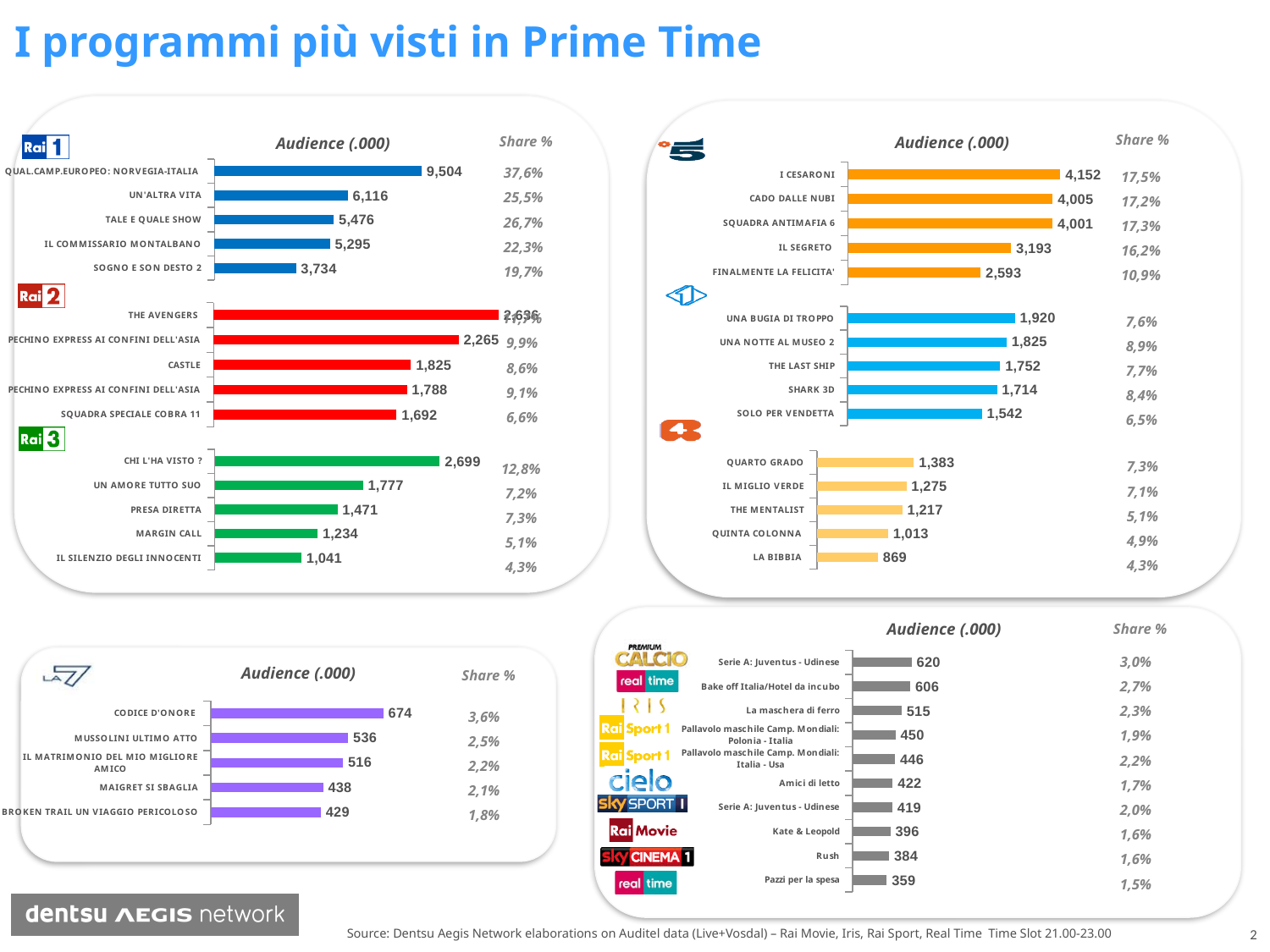
In the bottom-right chart, what is the Share % for Bake off Italia/Hotel da incubo? 2,7% In the top-right chart, what is the audience (.000) for UNA BUGIA DI TROPPO on Italia 1? 1,920 In the top-left chart, which Rai 3 programme has the lowest audience? IL SILENZIO DEGLI INNOCENTI What type of chart is used in the bottom-left La7 panel? Bar chart In the bottom-left La7 chart, what is the audience (.000) for CODICE D'ONORE? 674 In the top-right chart, what is the difference in audience (.000) between QUARTO GRADO and LA BIBBIA on Rete 4? 514 In the bottom-right chart, which has the larger audience: La maschera di ferro or Rush? La maschera di ferro In the top-left chart, what is the Share % for TALE E QUALE SHOW on Rai 1? 26,7% In the top-right chart, which Canale 5 programme has the highest audience? I CESARONI In the top-right chart, what is the audience (.000) for IL SEGRETO? 3,193 In the top-left chart, what is the audience (.000) for QUAL.CAMP.EUROPEO: NORVEGIA-ITALIA on Rai 1? 9,504 In the bottom-left La7 chart, how many programmes are listed? 5